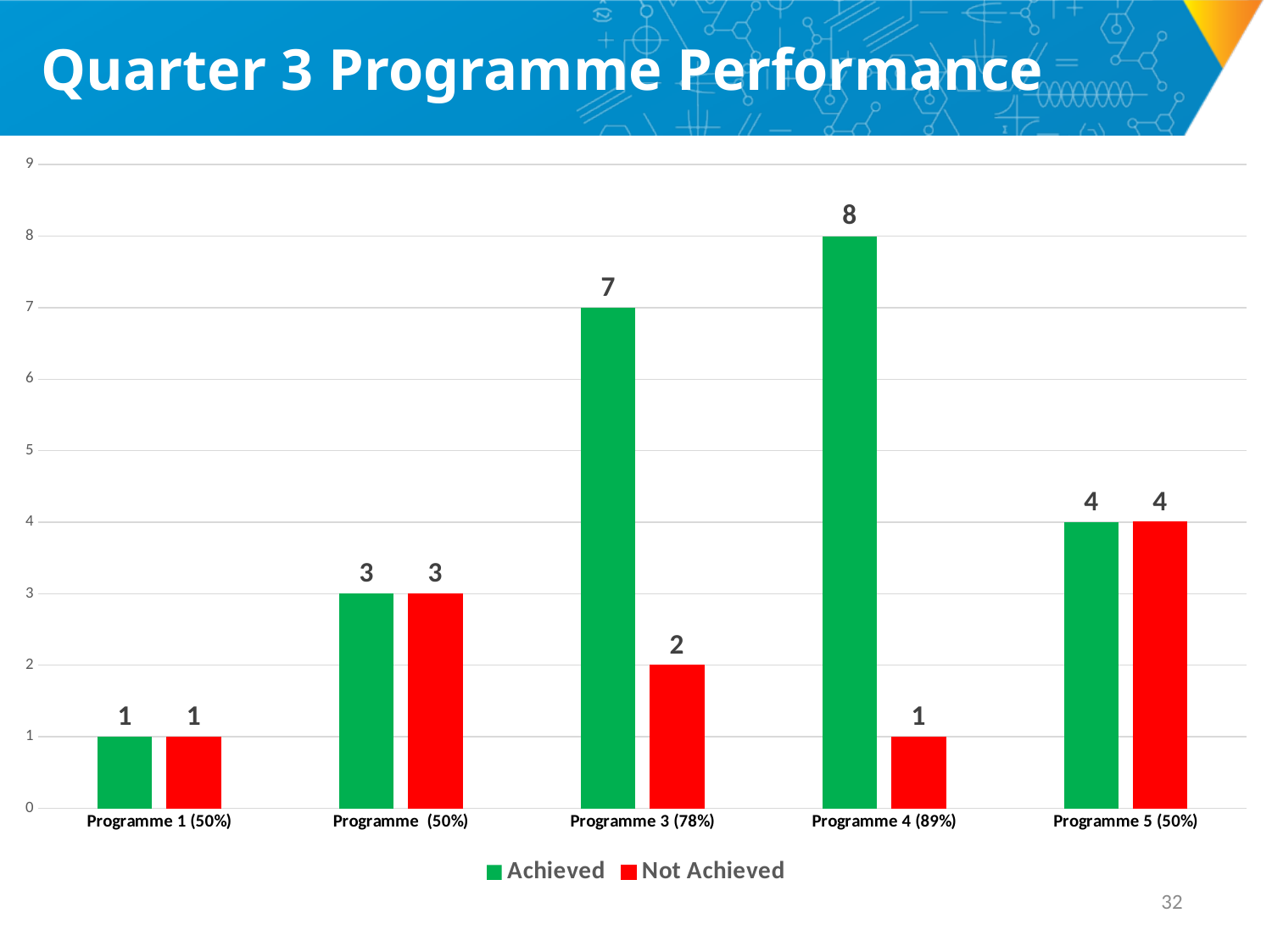
What is the Not Achieved value for Programme 3 (78%)? 2 What is the Achieved value for Programme 5 (50%)? 4 How many series does the legend list? 2 What is the title of the slide? Quarter 3 Programme Performance What kind of chart is shown on the slide? Bar chart Which colour represents the Not Achieved series? Red Which programme has the highest Achieved value? Programme 4 (89%) Which is larger, the Achieved value for Programme 3 (78%) or the Achieved value for Programme 5 (50%)? Programme 3 (78%) How many programmes are shown on the x axis? 5 Which programme has the lowest Not Achieved value? Programme 1 (50%) and Programme 4 (89%) What is the difference between the Achieved and Not Achieved values for Programme 3 (78%)? 5 What is the Achieved value for Programme 4 (89%)? 8